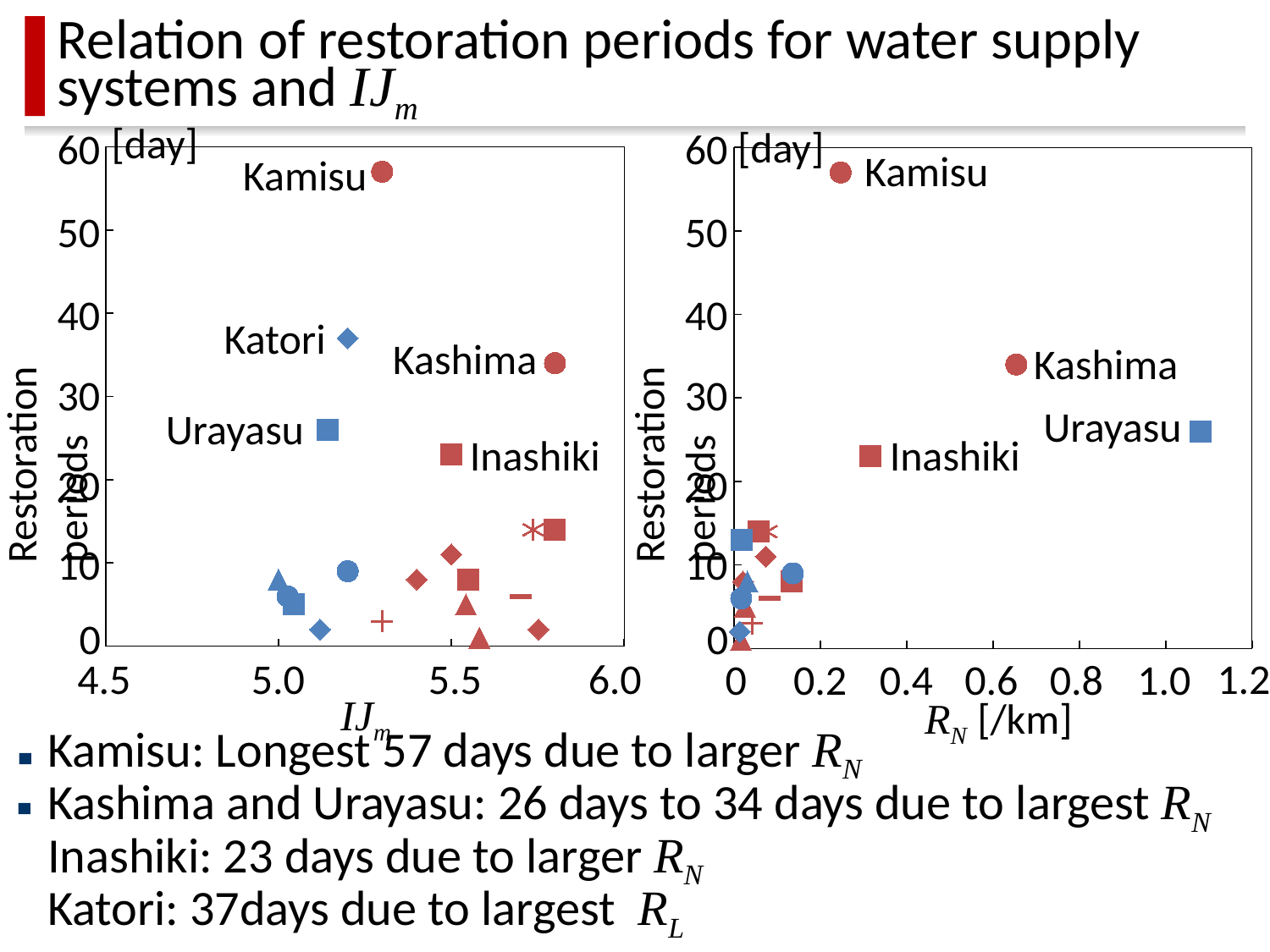
In the left chart (Restoration periods vs IJm), which has the longer restoration period, Kashima or Inashiki? Kashima In the left chart (Restoration periods vs IJm), is the restoration period for Urayasu greater or less than 30 days? less In the right chart (Restoration periods vs R_N), is the R_N value for Kamisu greater or less than 0.4 /km? less According to the slide, what is the restoration period for Kamisu? 57 days What kind of chart is the left chart (Restoration periods vs IJm)? scatter chart In the right chart (Restoration periods vs R_N), is the R_N value for Kashima greater or less than 0.4 /km? greater What is the x-axis label of the right chart? R_N [/km] How many cities are labeled by name in the right chart (Restoration periods vs R_N)? 4 In the right chart (Restoration periods vs R_N), which labeled city has the largest R_N value? Urayasu In the left chart (Restoration periods vs IJm), which labeled city has the longest restoration period? Kamisu